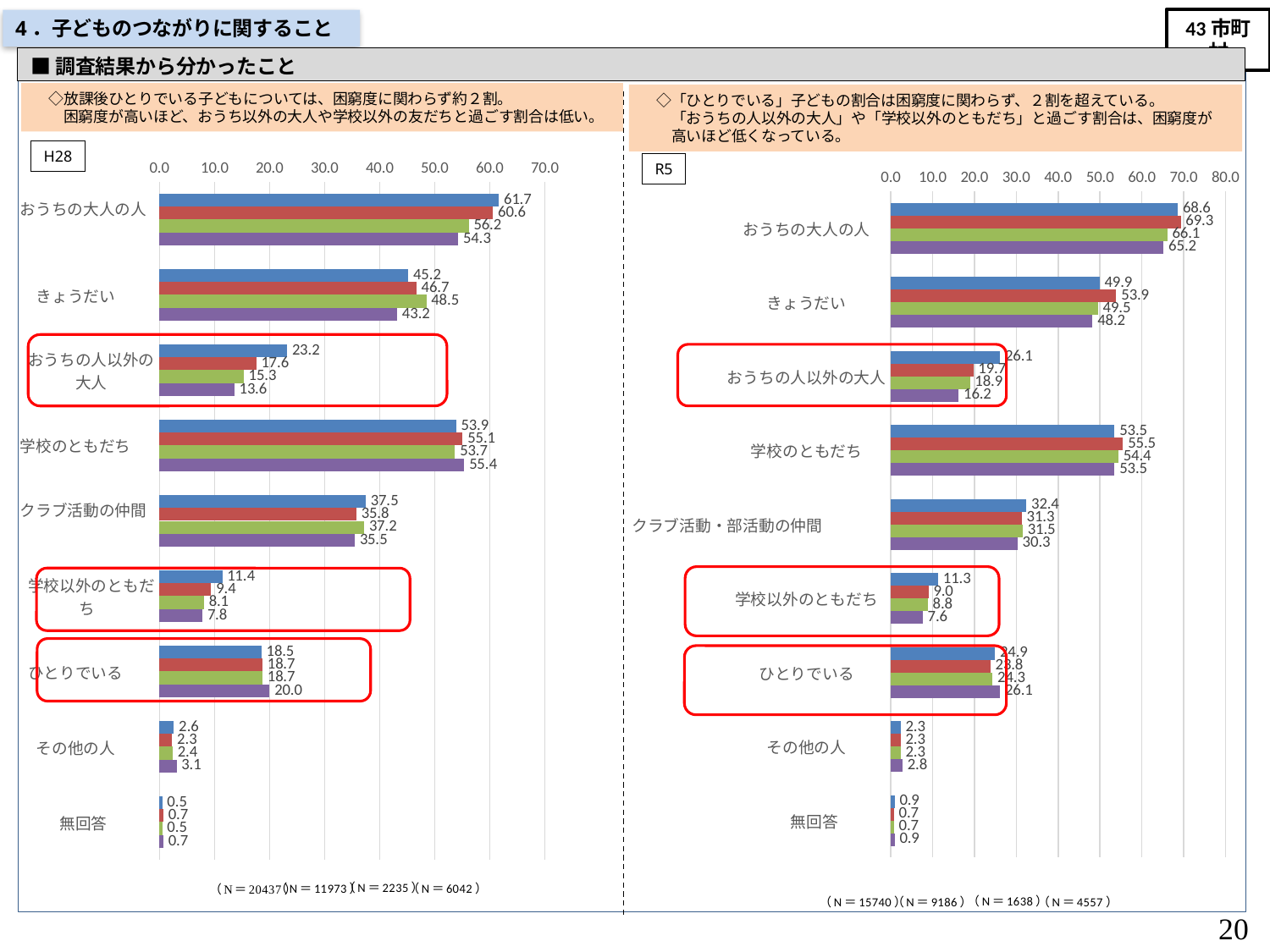
In the R5 chart, is the blue bar for クラブ活動・部活動の仲間 greater or less than 30.0? greater In the H28 chart, which category has the highest blue bar? おうちの大人の人 How many categories are shown on the y axis of the H28 chart? 9 In the R5 chart, which category has the lowest purple bar? 無回答 In the R5 chart, which is larger for ひとりでいる: the blue bar or the purple bar? the purple bar In the R5 chart, what is the value of the red bar for きょうだい? 53.9 In the R5 chart, what is the difference between the blue bar and the purple bar for 学校以外のともだち? 3.7 In the R5 chart, what is the value of the purple bar for ひとりでいる? 26.1 In the H28 chart, what is the value of the purple bar for おうちの人以外の大人? 13.6 What type of chart is the R5 chart? bar chart In the H28 chart, what is the difference between the blue bar and the purple bar for おうちの人以外の大人? 9.6 In the H28 chart, what is the value of the blue bar for おうちの大人の人? 61.7